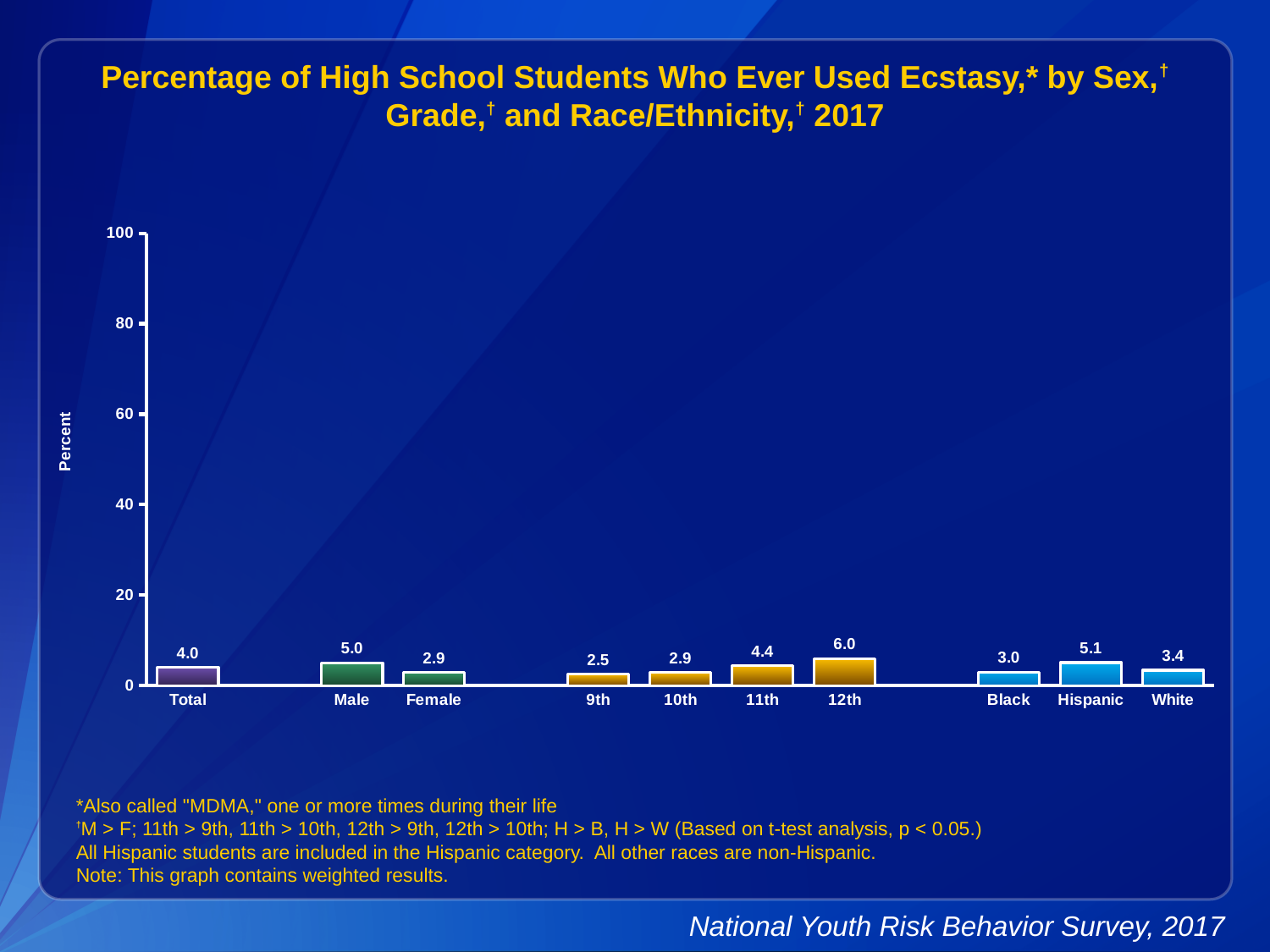
Which category has the highest value? 12th What kind of chart is shown? bar chart Which category has the lowest value? 9th Which is larger, the value for Hispanic or the value for White? Hispanic What is the value for 12th grade? 6.0 Is the value for 11th grade greater or less than 20? less What is the difference between the Male and Female values? 2.1 What is the value for Hispanic? 5.1 What is the value for Total? 4.0 How many categories are shown on the x axis? 10 What is the label on the y axis? Percent What is the value for Male? 5.0